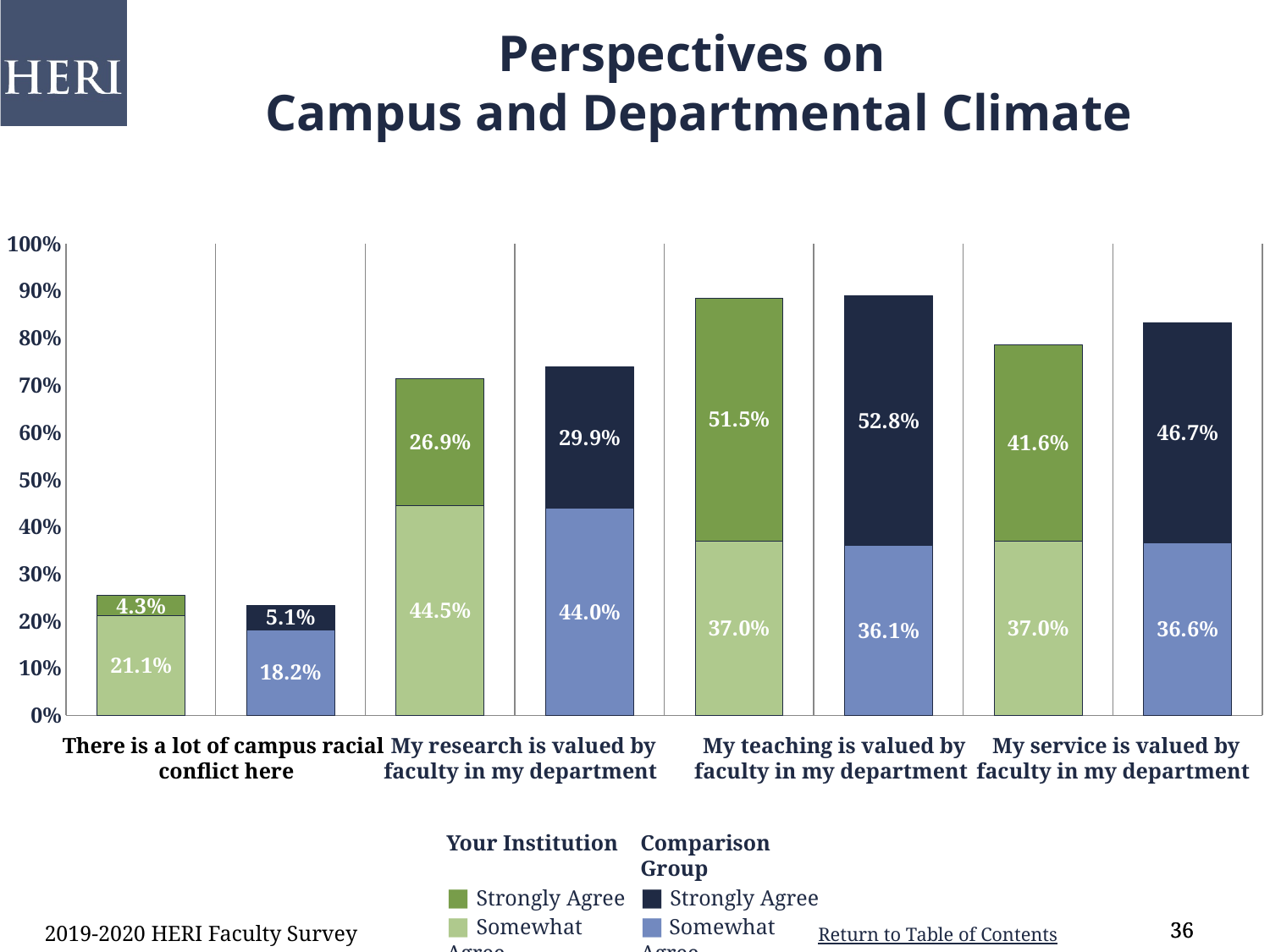
For which statement is the Your Institution 'Strongly Agree' value the highest? My teaching is valued by faculty in my department How many series does the legend list? 4 What is the total percentage of Your Institution faculty who strongly or somewhat agree that their research is valued by faculty in their department? 71.4% What percentage of the Comparison Group strongly agree that their service is valued by faculty in their department? 46.7% What type of chart is shown on the slide? Stacked bar chart How many statements (categories) are shown on the x axis of the chart? 4 What is the difference between the Comparison Group and Your Institution 'Strongly Agree' values for 'My service is valued by faculty in my department'? 5.1% What is the total percentage of the Comparison Group who strongly or somewhat agree that there is a lot of campus racial conflict here? 23.3% Which is larger: the Your Institution 'Somewhat Agree' value or the Comparison Group 'Somewhat Agree' value for 'My research is valued by faculty in my department'? Your Institution (44.5%) What percentage of Your Institution faculty strongly agree that their teaching is valued by faculty in their department? 51.5% For which statement is the Comparison Group 'Strongly Agree' value the lowest? There is a lot of campus racial conflict here What percentage of the Comparison Group somewhat agree that there is a lot of campus racial conflict here? 18.2%